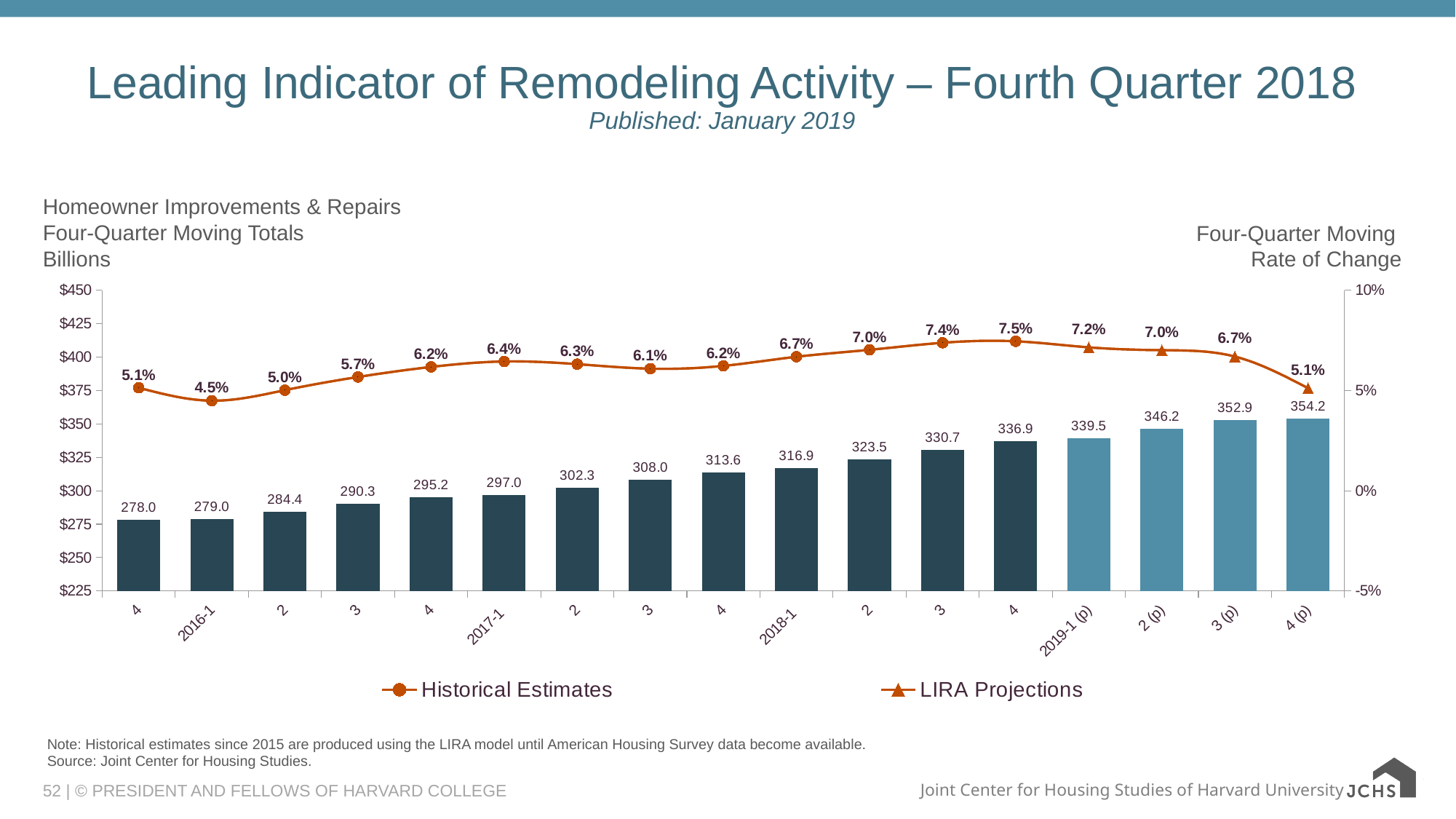
Which period has the highest four-quarter moving rate of change? 2018-4 What are the two series named in the legend? Historical Estimates and LIRA Projections What is the difference between the four-quarter moving totals for 2018-4 and 2017-4? 23.3 What is the projected four-quarter moving total for 4 (p) of 2019? 354.2 How many periods are shown on the x axis? 17 What kind of chart is used to show the four-quarter moving totals? bar chart Do the four-quarter moving totals rise or fall from 2015-4 to 2019-4 (p)? rise What is the four-quarter moving rate of change for 2017-1? 6.4% How many series does the legend list? 2 Which period has the lowest four-quarter moving rate of change? 2016-1 What is the four-quarter moving total (in billions) for 2018-1? 316.9 Which is larger, the rate of change for 2019-1 (p) or for 2019-3 (p)? 2019-1 (p)